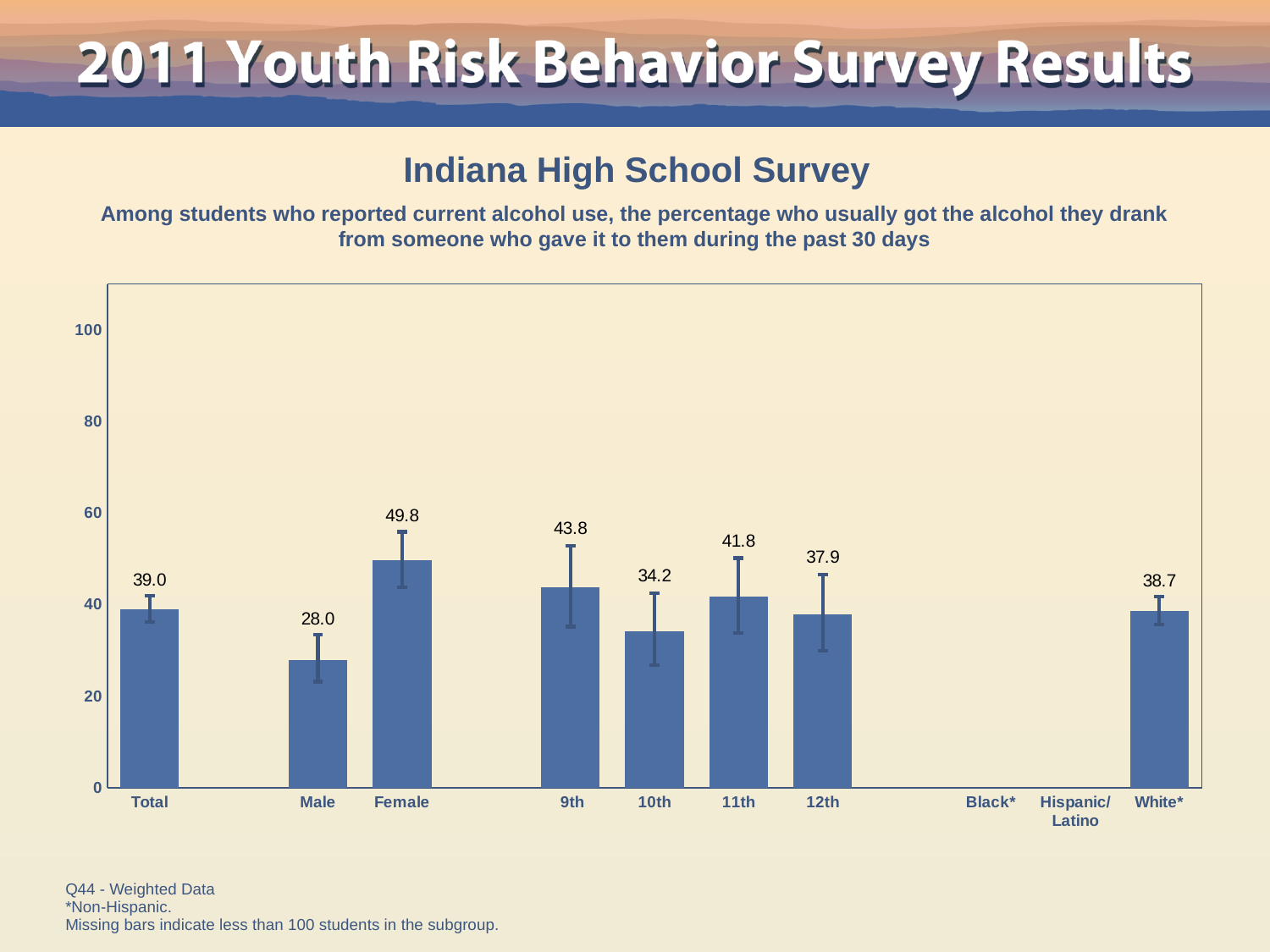
What is the value for Female? 49.8 How many categories have a bar plotted? 8 Which categories on the x axis have no bar? Black* and Hispanic/Latino What is the value for 10th grade? 34.2 Which category has the highest value? Female Which category with a bar has the lowest value? Male What kind of chart is shown? bar chart What is the value for Male? 28.0 What is the difference between the Female and Male values? 21.8 Is the value for 11th grade greater or less than 40? greater What is the value for White*? 38.7 Which is larger, the value for 9th grade or 12th grade? 9th